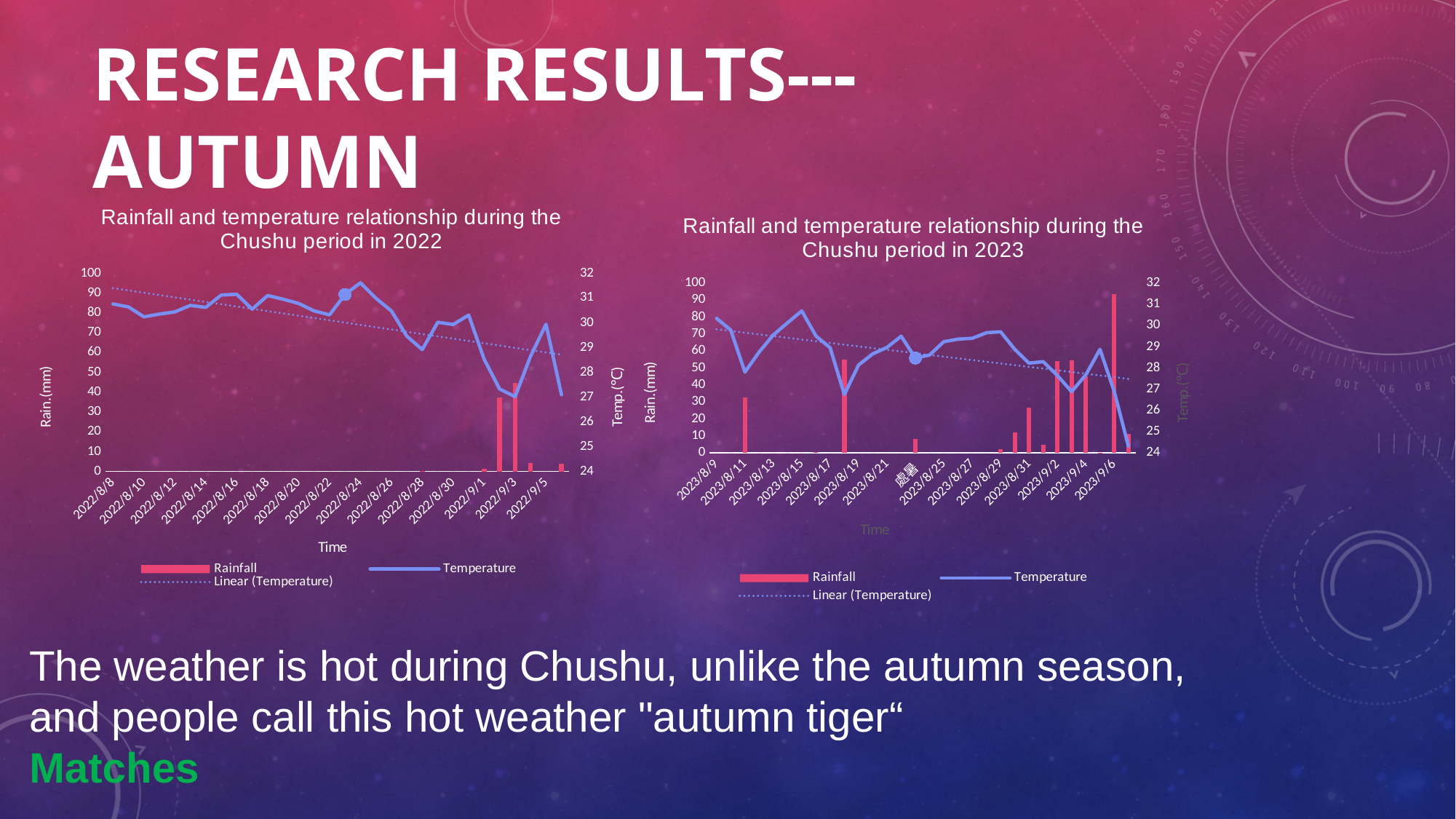
What is the title of the chart on the left? Rainfall and temperature relationship during the Chushu period in 2022 In the 2023 chart, does the temperature trend line rise or fall across the period? fall In the 2022 chart, which date has the higher rainfall, 2022/9/2 or 2022/9/3? 2022/9/3 What is the label of the right-hand vertical axis in the 2022 chart? Temp.(°C) In the 2022 chart, is the temperature on 2022/8/24 greater or less than 30? greater In the 2023 chart, how many entries does the legend list? 3 In the 2023 chart, is the rainfall on 2023/9/6 greater or less than 80? greater In the 2022 chart, is the rainfall on 2022/9/3 greater or less than 50? less In the 2023 chart, on which date is the rainfall bar highest? 2023/9/6 In the 2023 chart, which date has the higher rainfall, 2023/8/11 or 2023/8/18? 2023/8/18 What kind of chart is the 2022 chart? Combination bar and line chart